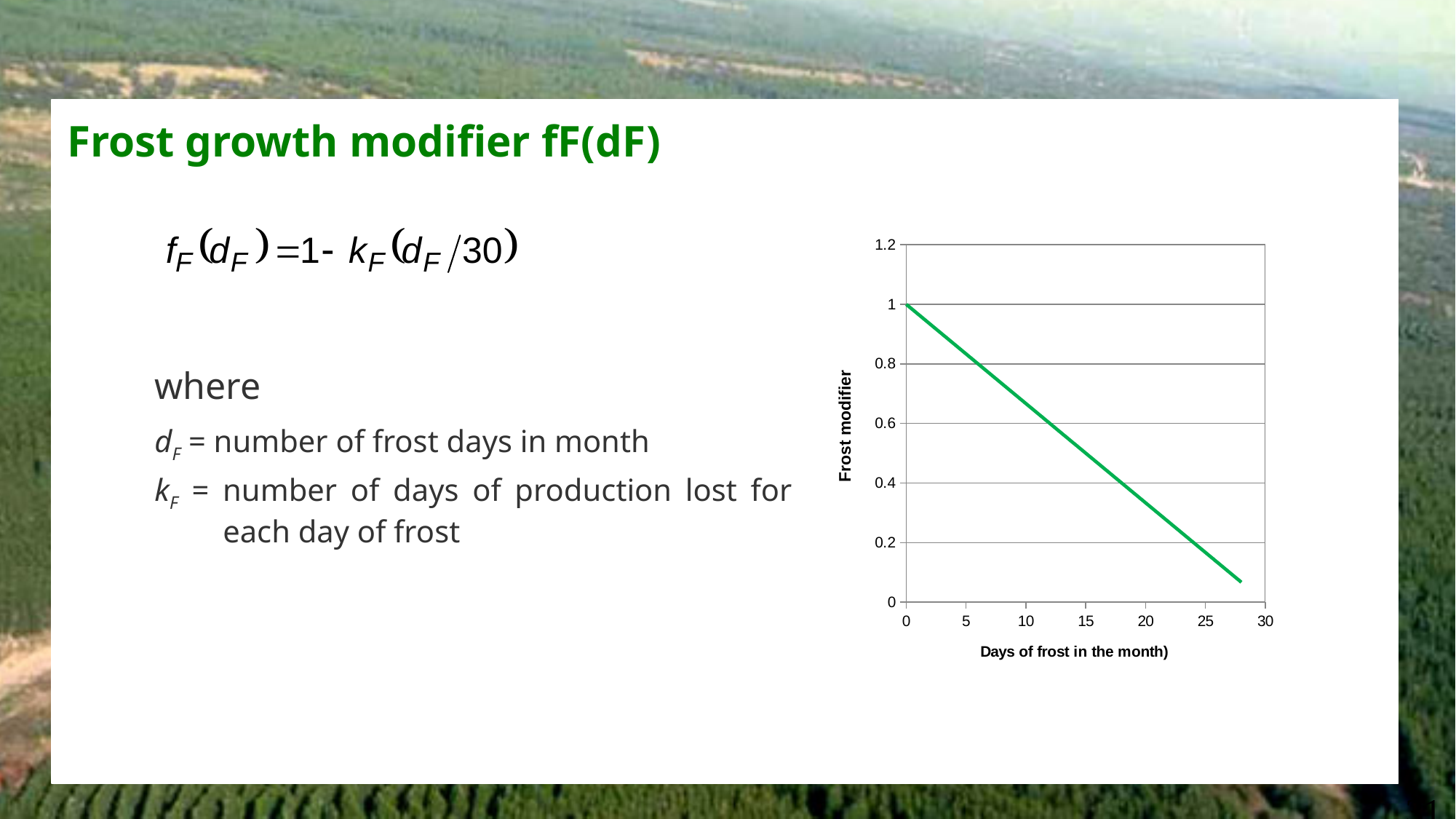
At which end of the x axis, 0 days or 28 days, is the frost modifier lowest? 28 days Is the frost modifier at 10 days of frost greater or less than 0.6? greater What kind of chart is shown on the slide? line chart Is the frost modifier at 15 days of frost greater or less than 0.6? less Which has the larger frost modifier: 5 days of frost or 25 days of frost? 5 days of frost Is the frost modifier at 20 days of frost greater or less than 0.4? less What is the label of the vertical axis of the chart? Frost modifier What is the highest value shown on the vertical axis of the chart? 1.2 Does the frost modifier rise or fall as the days of frost in the month increase? fall What is the frost modifier value when the number of days of frost is 0? 1